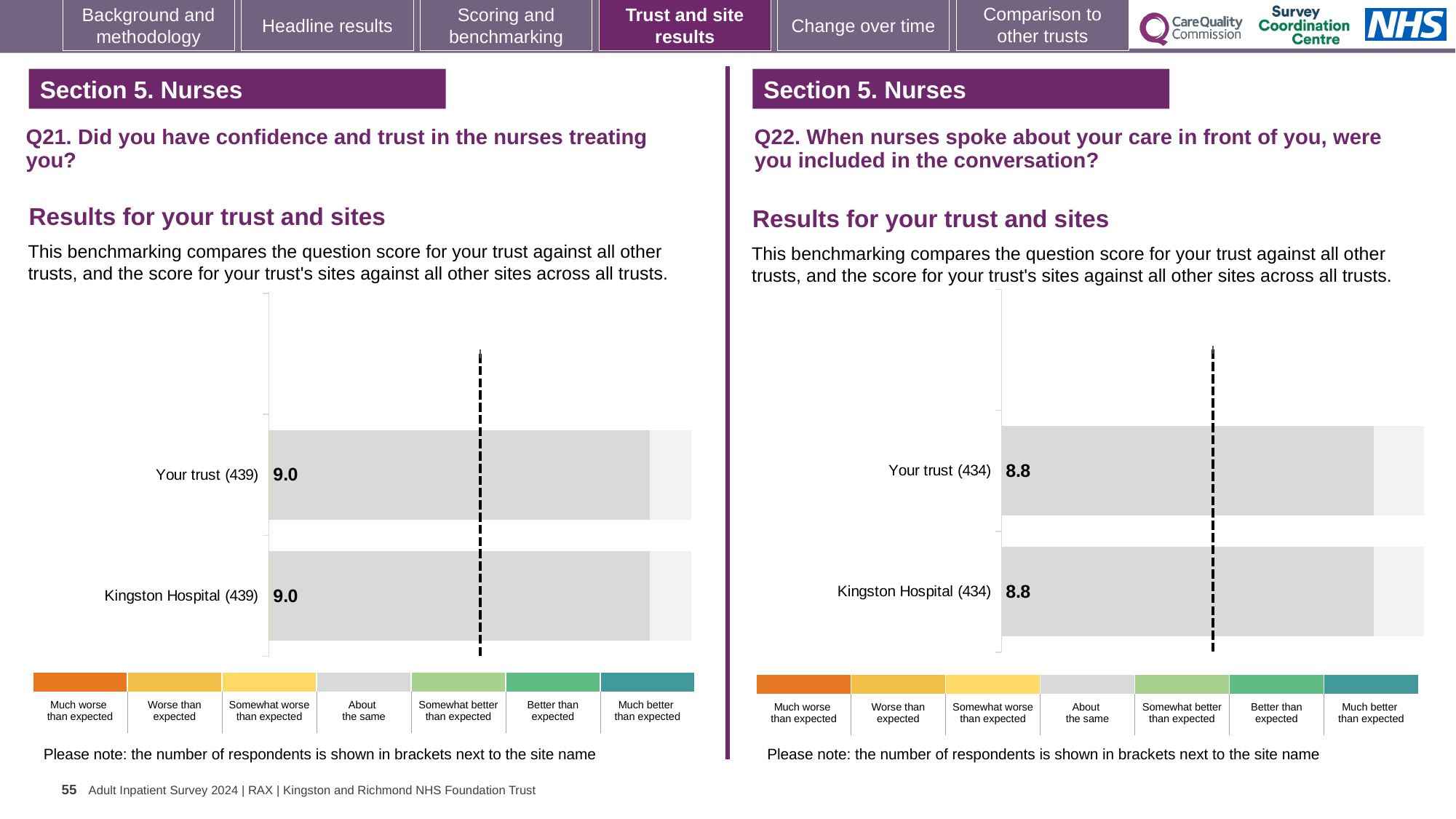
On the Q21 chart (left), what is the difference between the score for Your trust and the score for Kingston Hospital? 0.0 On the Q22 chart (right), what is the score for Kingston Hospital? 8.8 On the Q22 chart (right), what is the score for Your trust? 8.8 What kind of chart is the Q21 chart (left)? Bar chart On the Q22 chart (right), which benchmark category does the colour key label with the darkest teal colour at the far right? Much better than expected On the Q21 chart (left), how many bars are plotted? 2 On the Q21 chart (left), what is the score for Kingston Hospital? 9.0 On the Q21 chart (left), what is the score for Your trust? 9.0 On the Q22 chart (right), how many bars are plotted? 2 On the Q21 chart (left), how many respondents are shown in brackets next to Kingston Hospital? 439 On the Q22 chart (right), how many respondents are shown in brackets next to Your trust? 434 On the Q22 chart (right), what is the difference between the score for Your trust and the score for Kingston Hospital? 0.0